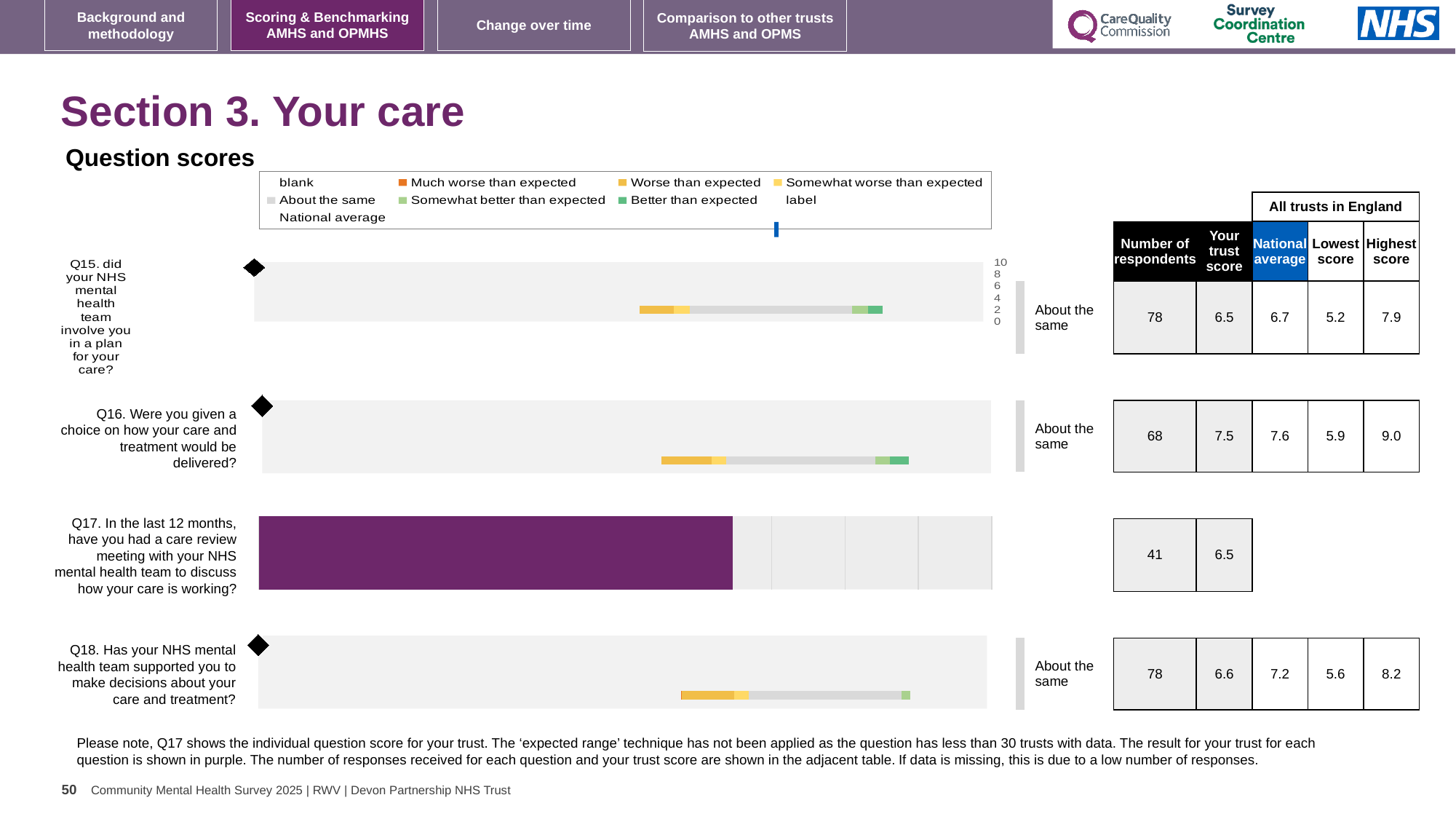
What is the difference between the national average and the trust score for Q18? 0.6 Which question has the lowest national average on this slide? Q15 Which question's bar is shown in purple? Q17 What is the highest score among all trusts in England for Q18? 8.2 Which question has the highest trust score on this slide? Q16 For Q16, which is larger: the trust score or the national average? National average How many respondents answered Q17? 41 What is the lowest score among all trusts in England for Q15? 5.2 What is the national average for Q16 (were you given a choice on how your care and treatment would be delivered)? 7.6 What kind of chart is used to show the question scores? Bar chart How many questions are charted on this slide? 4 What is the trust score for Q15 (did your NHS mental health team involve you in a plan for your care)? 6.5